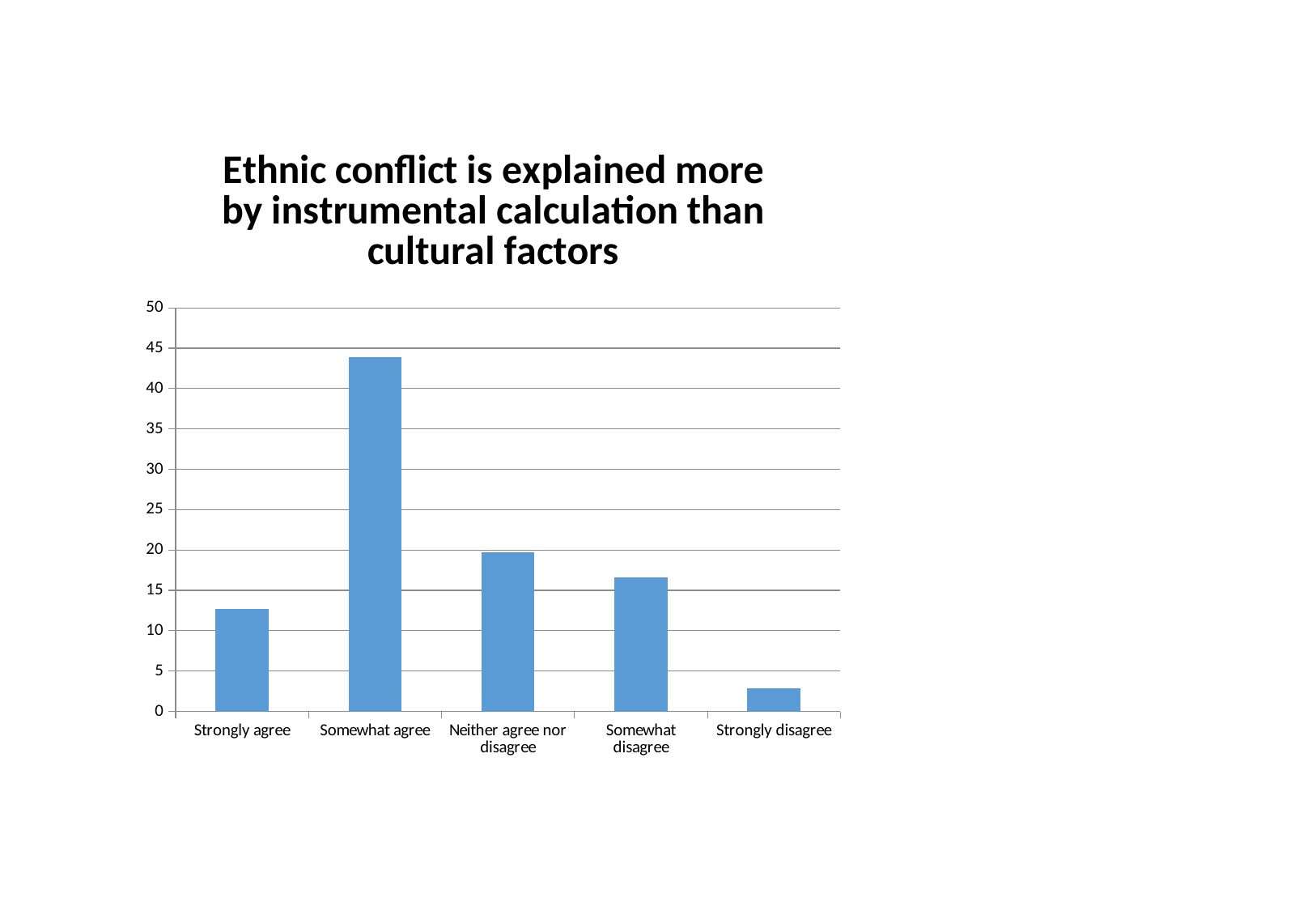
What kind of chart is shown on the slide? bar chart Which category has the highest value? Somewhat agree What is the title of the chart? Ethnic conflict is explained more by instrumental calculation than cultural factors Is the value for Neither agree nor disagree greater or less than 15? greater Is the value for Strongly agree greater or less than 10? greater Is the value for Somewhat agree greater or less than 40? greater Which category has the lowest value? Strongly disagree How many categories are shown on the x axis? 5 Which is larger, the value for Neither agree nor disagree or the value for Somewhat disagree? Neither agree nor disagree Which is larger, the value for Strongly agree or the value for Somewhat disagree? Somewhat disagree